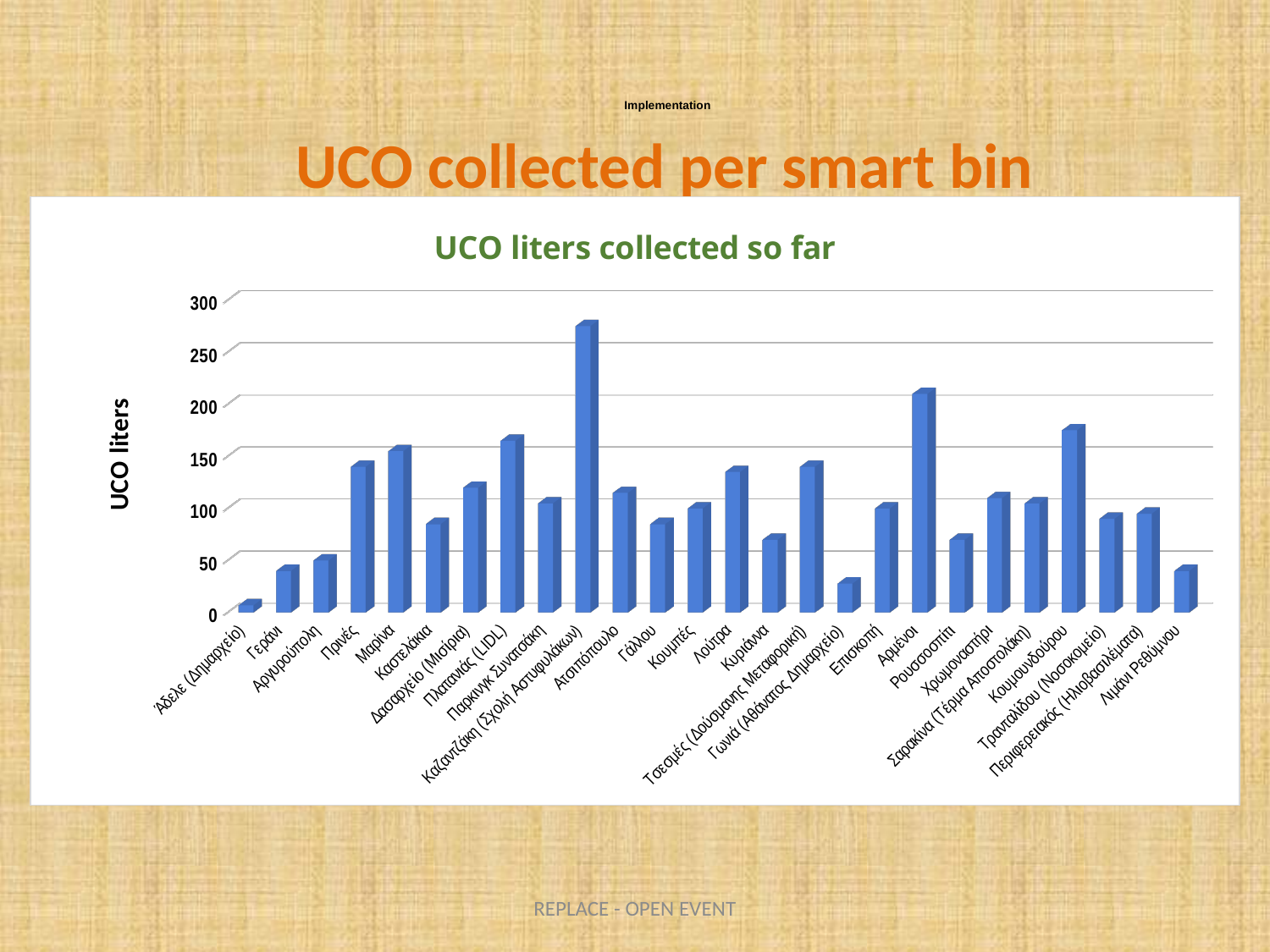
What is the title of the chart? UCO liters collected so far What is the label of the vertical axis? UCO liters How many smart bin locations (bars) are shown in the chart? 26 Which location has the highest UCO liters collected? Καζαντζάκη (Σχολή Αστυφυλάκων) Is the value for Αρμένοι greater or less than 200? greater Is the value for Λιμάνι Ρεθύμνου greater or less than 50? less Is the value for Γωνιά (Αθάνατος Δημαρχείο) greater or less than 50? less Which has more UCO liters collected, Πρινές or Γεράνι? Πρινές What kind of chart is shown on the slide? bar chart Which location has the lowest UCO liters collected? Άδελε (Δημαρχείο) Which has more UCO liters collected, Αρμένοι or Κουμουνδούρου? Αρμένοι